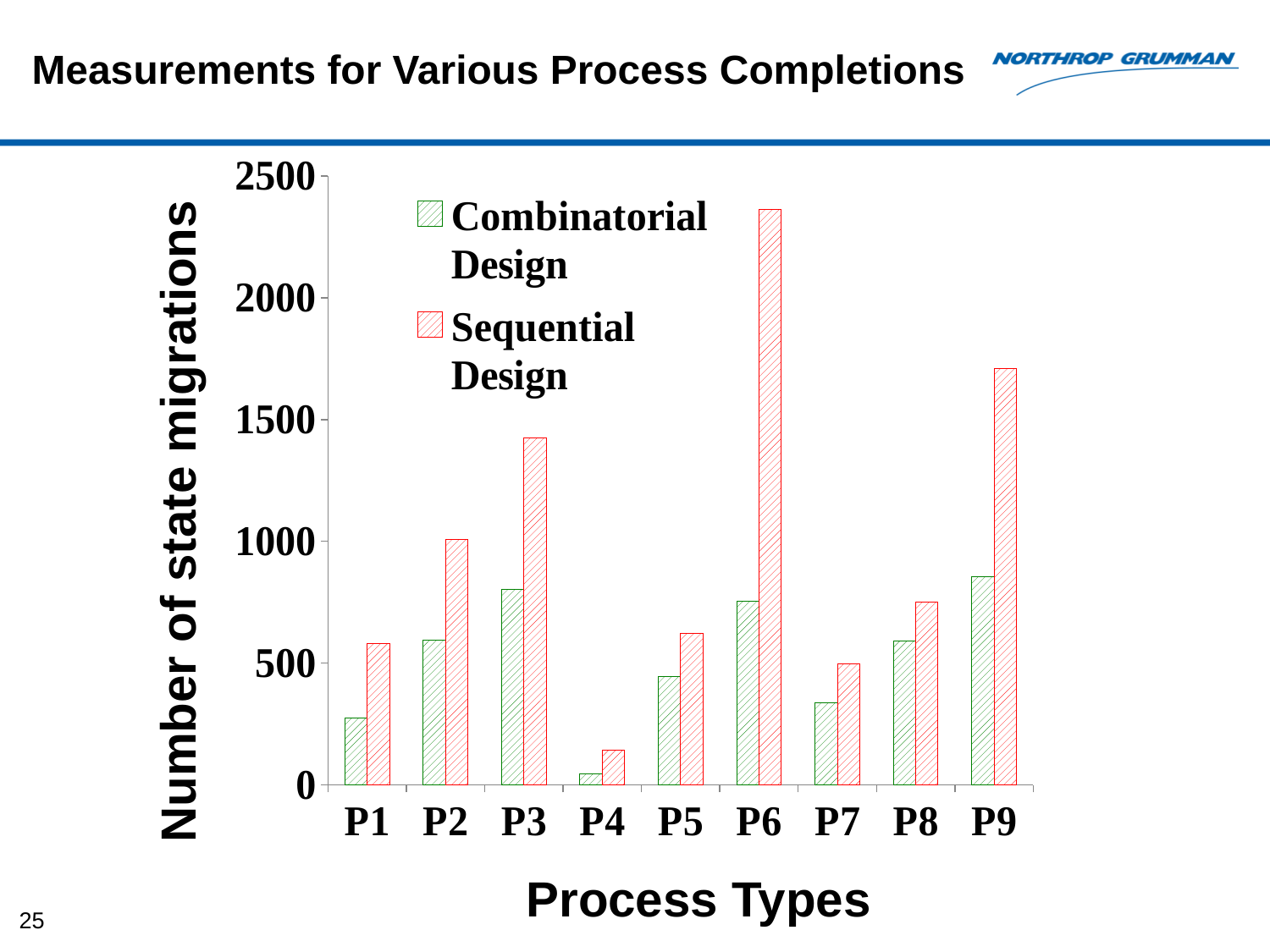
How many process types are shown on the x axis? 9 Is the Sequential Design value for P3 greater or less than 1500? less What is the title of the y axis? Number of state migrations Is the Combinatorial Design value for P4 greater or less than 500? less Is the Sequential Design value for P6 greater or less than 2000? greater Which process type has the lowest Combinatorial Design value? P4 Which process type has the highest Sequential Design value? P6 Which process type has the lowest Sequential Design value? P4 What kind of chart is shown on the slide? bar chart How many series does the legend list? 2 For P6, which is larger: the Combinatorial Design value or the Sequential Design value? Sequential Design